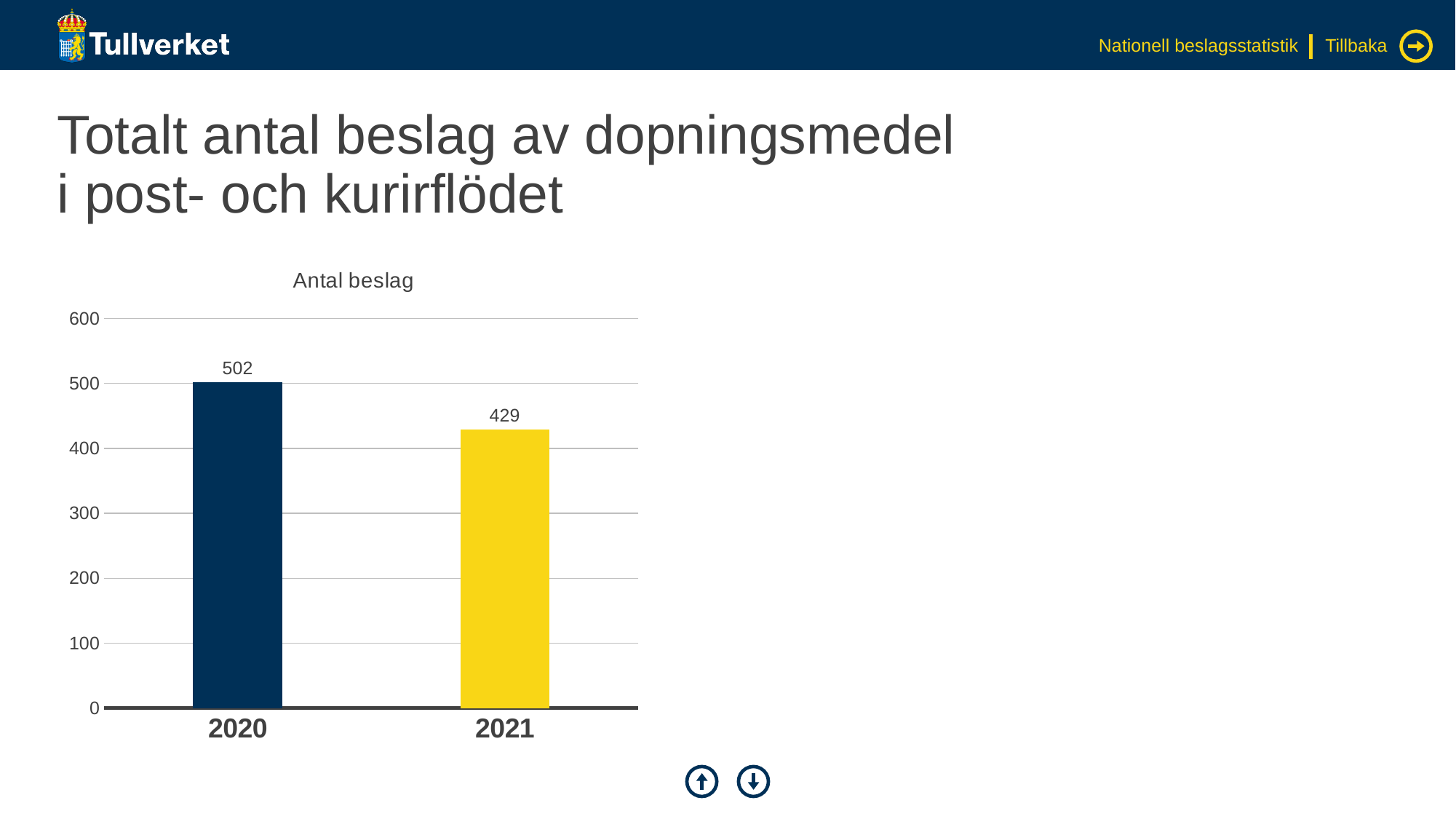
What is the value for 2020? 502 Is the value for 2021 greater or less than 500? less Do the values rise or fall from 2020 to 2021? fall What is the value for 2021? 429 Which year has the highest value? 2020 What kind of chart is shown? bar chart Which year has the lowest value? 2021 What is the difference between the values for 2020 and 2021? 73 How many years are shown on the x axis? 2 Is the value for 2020 greater or less than 400? greater Which is larger, the value for 2020 or the value for 2021? 2020 What is the title of the chart? Antal beslag